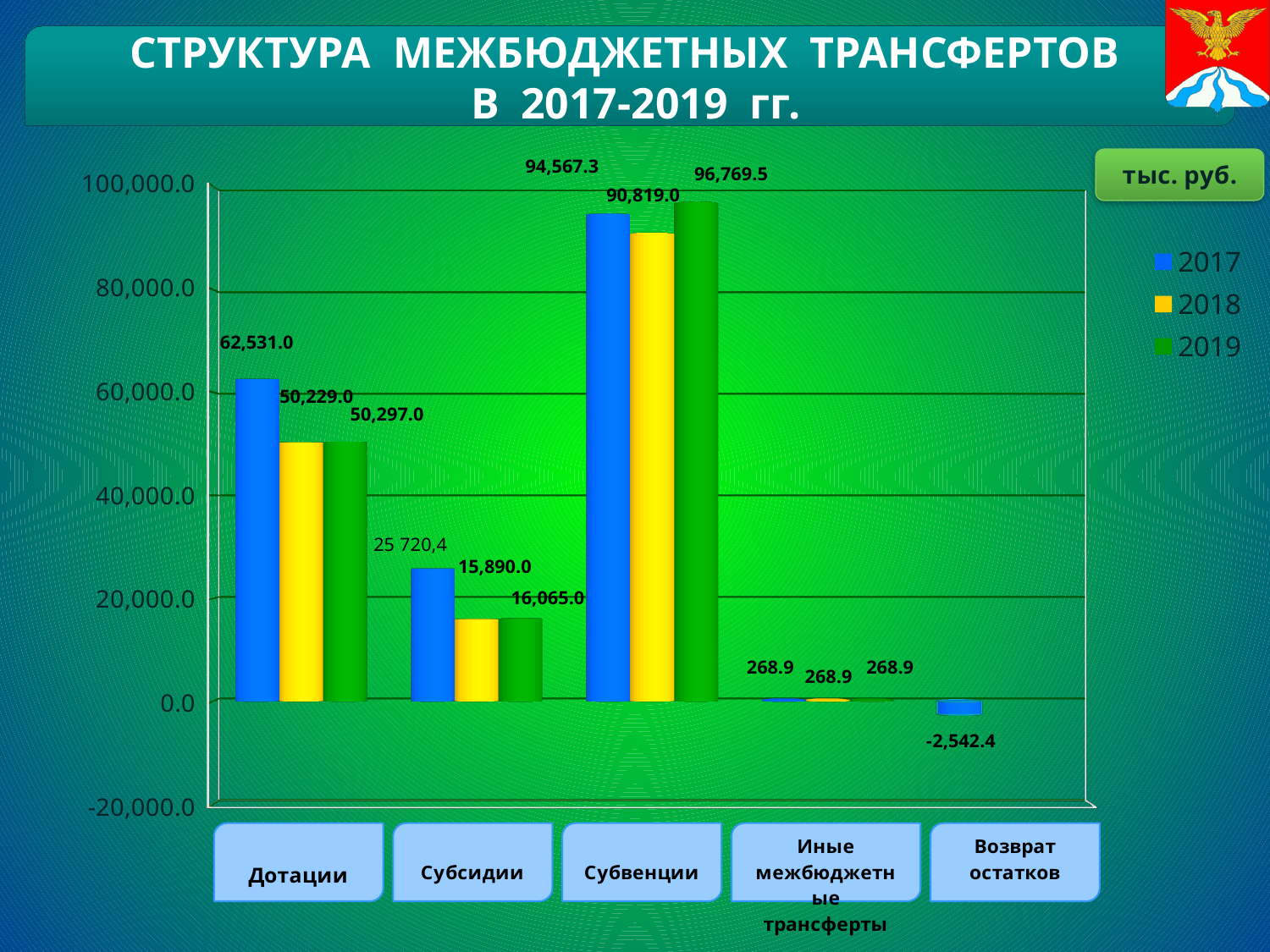
How many series does the legend list? 3 What is the difference between the 2017 and 2018 values for Дотации? 12,302.0 What unit is indicated in the box at the top right of the chart? тыс. руб. Which is larger for Субвенции: the 2018 value or the 2019 value? 2019 What is the value for Возврат остатков in 2017? -2,542.4 Which category has the highest value in 2019? Субвенции What is the value for Субсидии in 2018? 15,890.0 Is the value for Субсидии in 2019 greater or less than 20,000.0? less What is the value for Дотации in 2017? 62,531.0 Which category has the lowest value in 2017? Возврат остатков What type of chart is shown on the slide? bar chart What is the value for Субвенции in 2019? 96,769.5